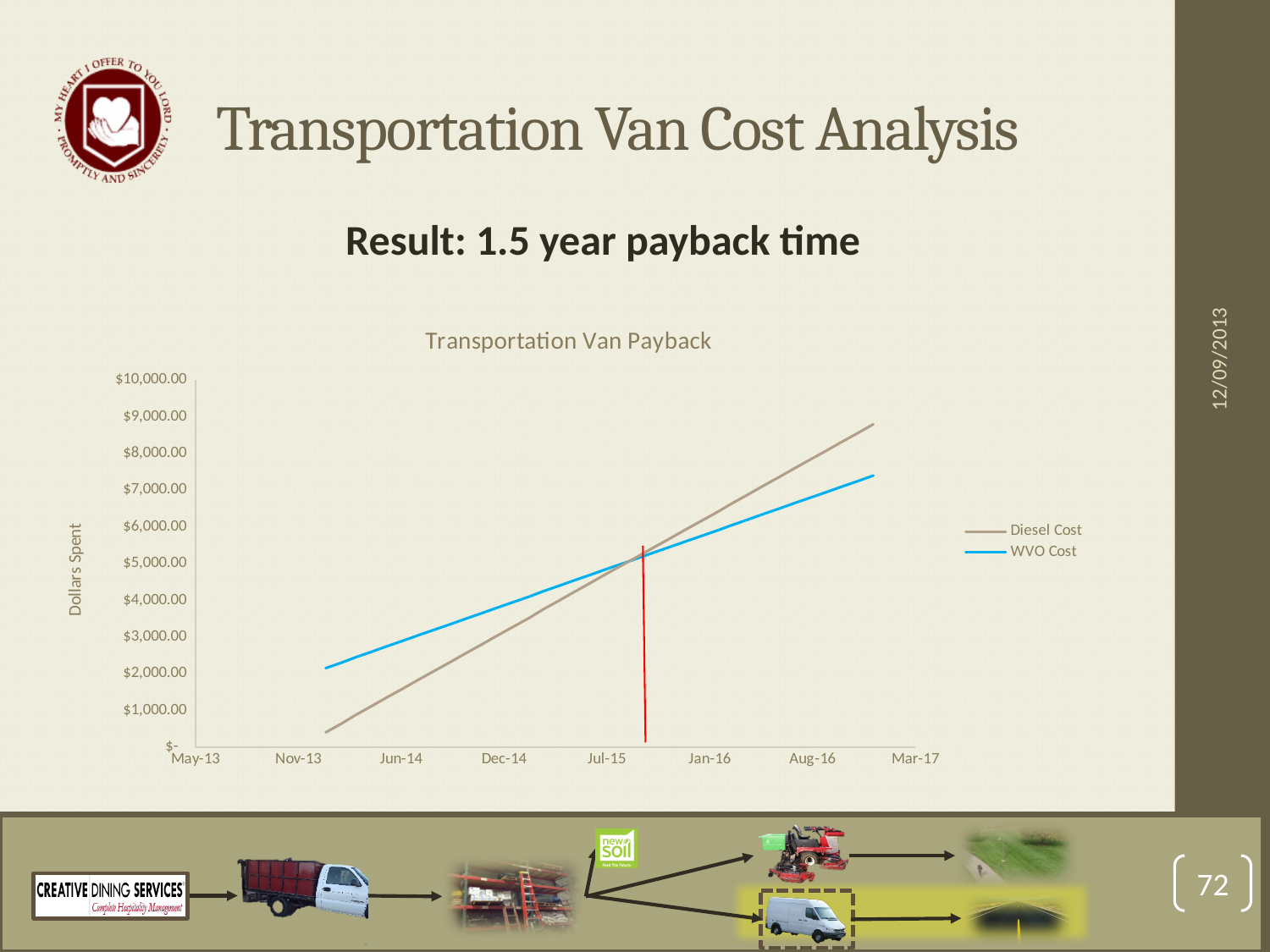
What are the two series named in the legend? Diesel Cost and WVO Cost At the right end of the chart, which series has the higher value, Diesel Cost or WVO Cost? Diesel Cost Is the WVO Cost value at the left end of the line greater or less than $3,000.00? less How many series does the legend list? 2 At the left end of the chart, which series has the higher value, Diesel Cost or WVO Cost? WVO Cost Is the Diesel Cost value at the right end of the line greater or less than $8,000.00? greater Do the Diesel Cost values rise or fall along the x axis? rise Is the Diesel Cost value at the left end of the line greater or less than $1,000.00? less What kind of chart is shown on the slide? line chart What is the title of the chart? Transportation Van Payback Do the WVO Cost values rise or fall along the x axis? rise How many date labels are shown on the x axis? 8